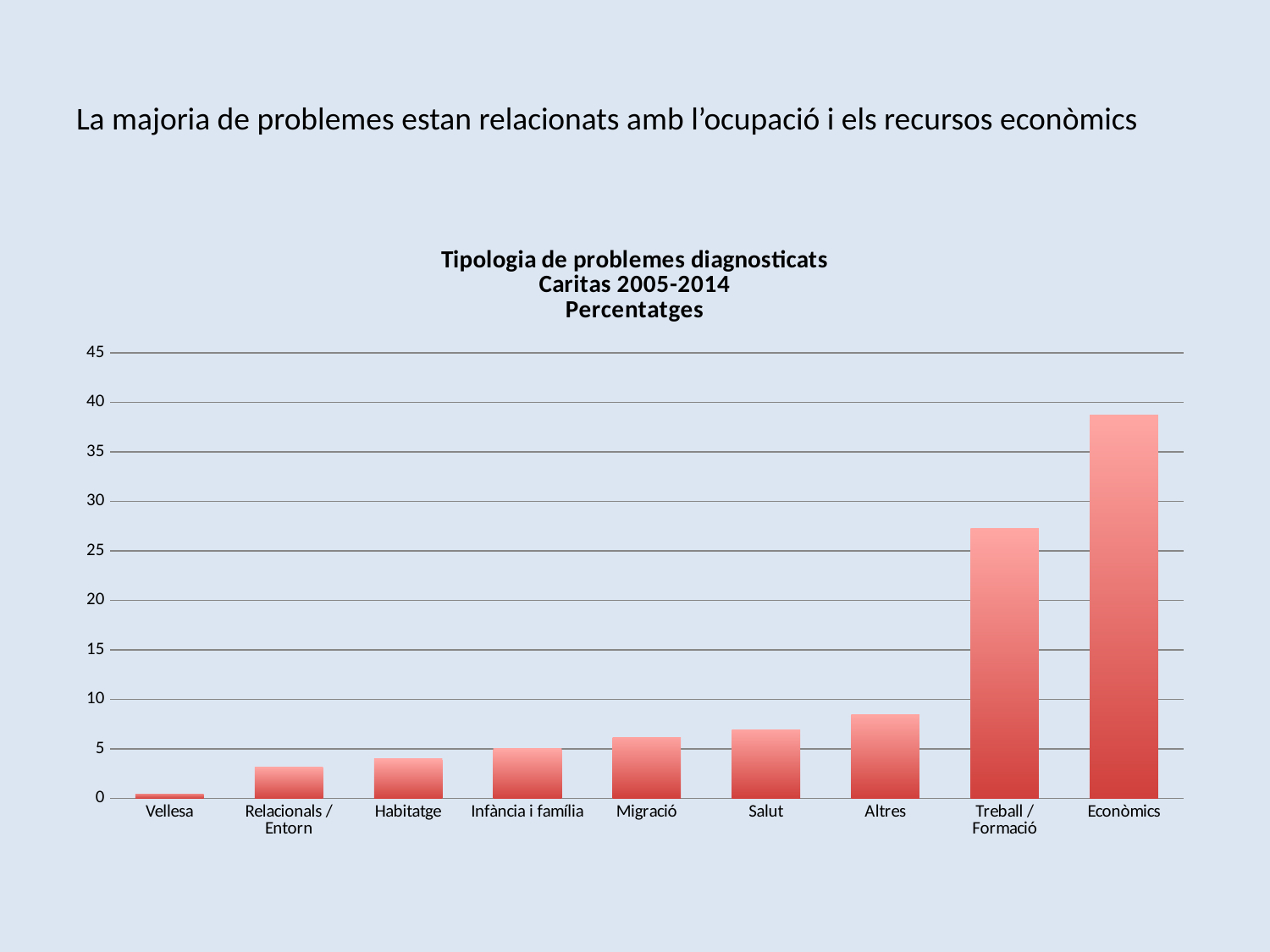
Do the values rise or fall from left to right along the x axis? rise What is the title of the chart? Tipologia de problemes diagnosticats Caritas 2005-2014 Percentatges Is the value for Treball / Formació greater or less than 25? greater Which category has the highest value in the chart? Econòmics Is the value for Salut greater or less than 5? greater Which category has the lowest value in the chart? Vellesa Is the value for Econòmics greater or less than 35? greater Which is larger, the value for Treball / Formació or the value for Econòmics? Econòmics How many categories are shown on the x axis of the chart? 9 What kind of chart is shown on the slide? bar chart